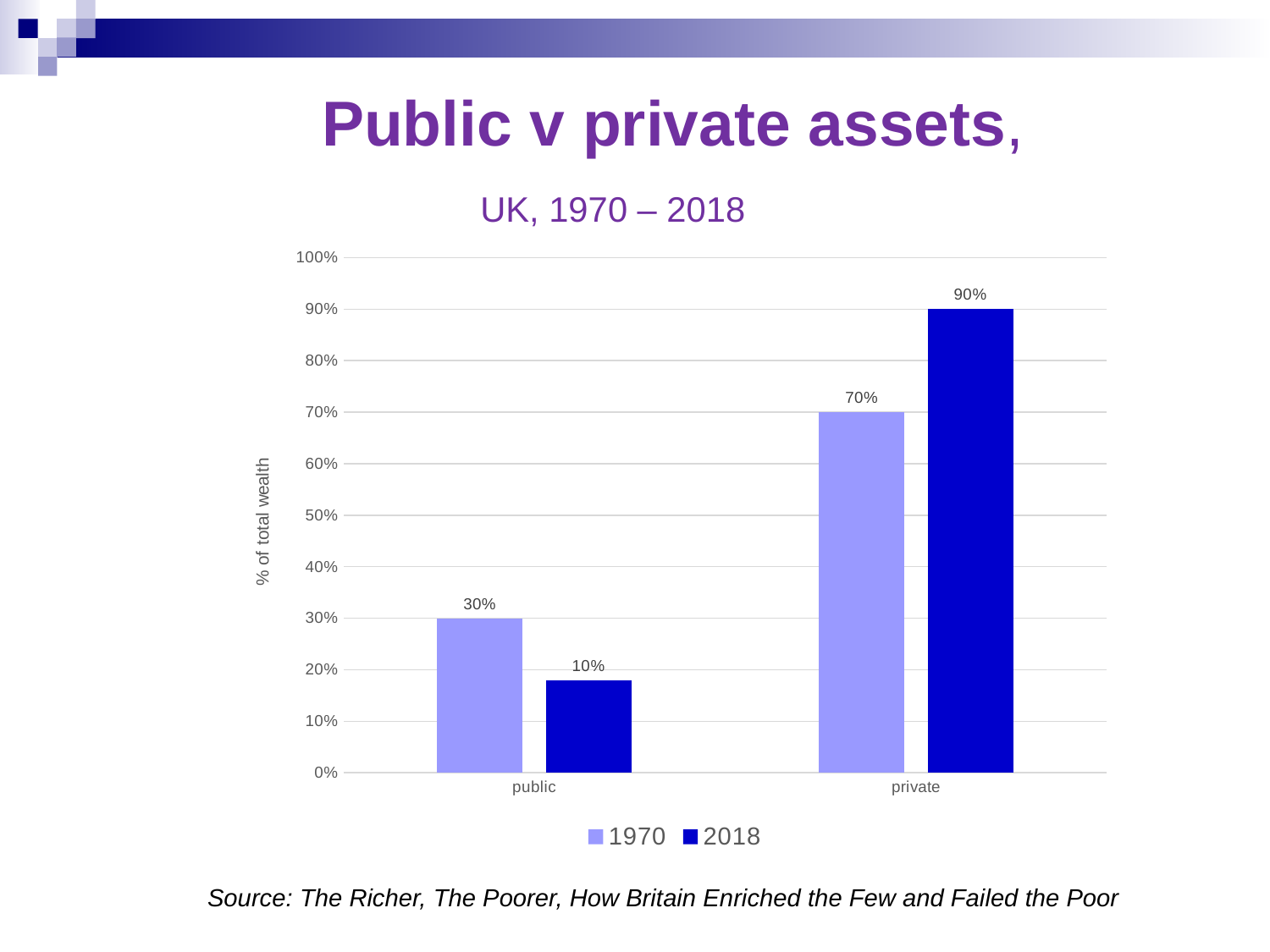
What is the difference between the public asset values for 1970 and 2018? 20% Which bar has the lowest value on the chart? public, 2018 What is the difference between the private asset values for 2018 and 1970? 20% What is the label on the vertical axis? % of total wealth What is the value for private assets in 2018? 90% How many series does the legend list? 2 What is the value for public assets in 2018? 10% What is the value for public assets in 1970? 30% What is the value for private assets in 1970? 70% Which bar has the highest value on the chart? private, 2018 Which is larger, the 1970 value for public assets or the 1970 value for private assets? private What kind of chart is shown on the slide? bar chart